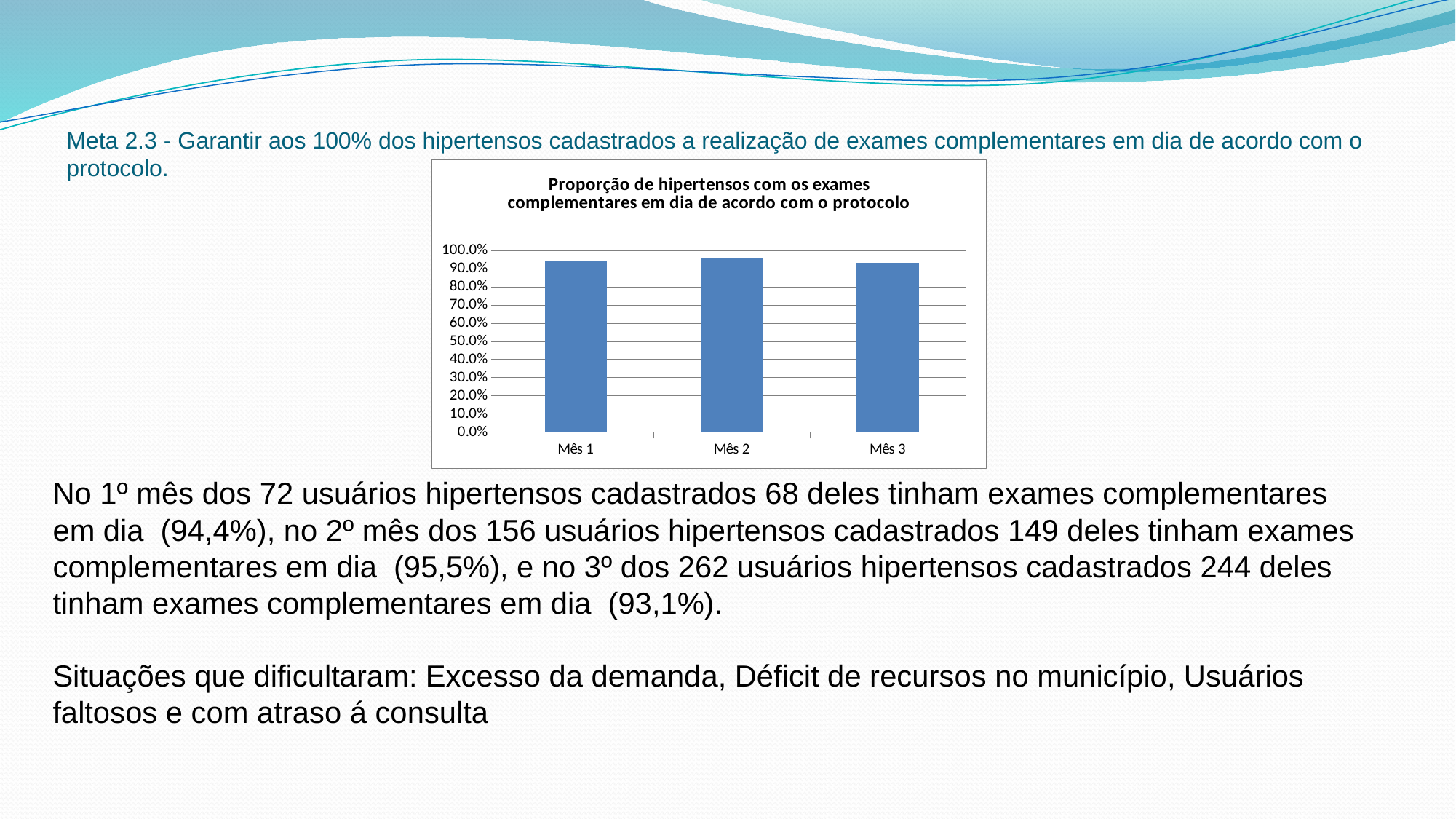
Is the value for Mês 2 greater or less than 90.0%? greater Is the value for Mês 3 greater or less than 90.0%? greater Is the value for Mês 2 greater or less than 100.0%? less What is the title of the chart? Proporção de hipertensos com os exames complementares em dia de acordo com o protocolo What kind of chart is shown on the slide? bar chart What is the highest value shown on the y axis of the chart? 100.0% How many categories (months) are shown on the x axis of the chart? 3